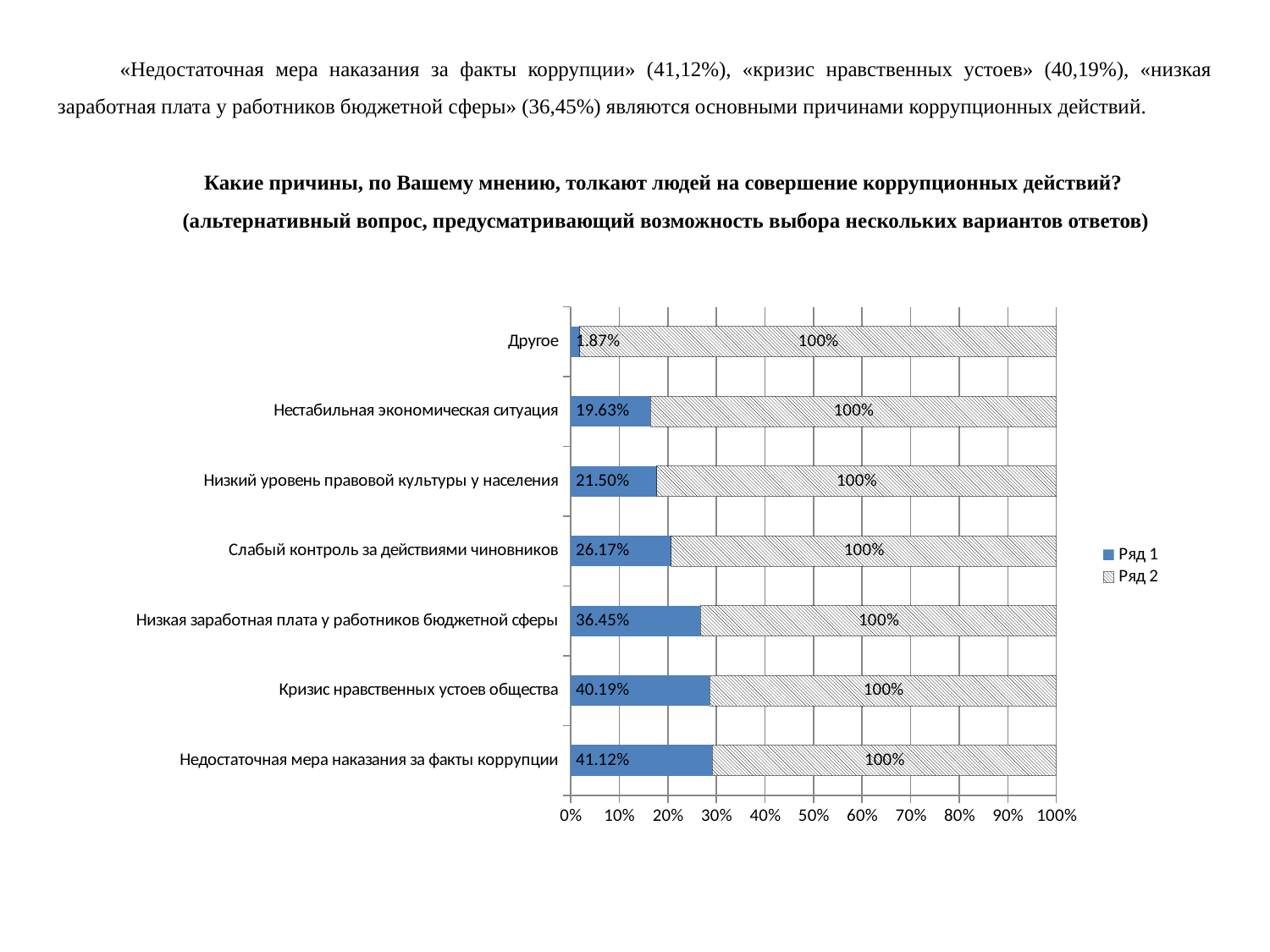
How many series does the legend list? 2 Which category has the highest Ряд 1 value? Недостаточная мера наказания за факты коррупции What is the Ряд 1 value for «Недостаточная мера наказания за факты коррупции»? 41.12% What is the Ряд 1 value for «Нестабильная экономическая ситуация»? 19.63% What is the Ряд 1 value for «Слабый контроль за действиями чиновников»? 26.17% What kind of chart is shown on the slide? Stacked bar chart Which has a larger Ряд 1 value: «Низкий уровень правовой культуры у населения» or «Слабый контроль за действиями чиновников»? Слабый контроль за действиями чиновников What is the Ряд 1 value for «Кризис нравственных устоев общества»? 40.19% What is the Ряд 1 value for «Низкая заработная плата у работников бюджетной сферы»? 36.45% Which category has the lowest Ряд 1 value? Другое How many categories are shown on the chart? 7 What is the difference between the Ряд 1 values for «Недостаточная мера наказания за факты коррупции» and «Кризис нравственных устоев общества»? 0.93%